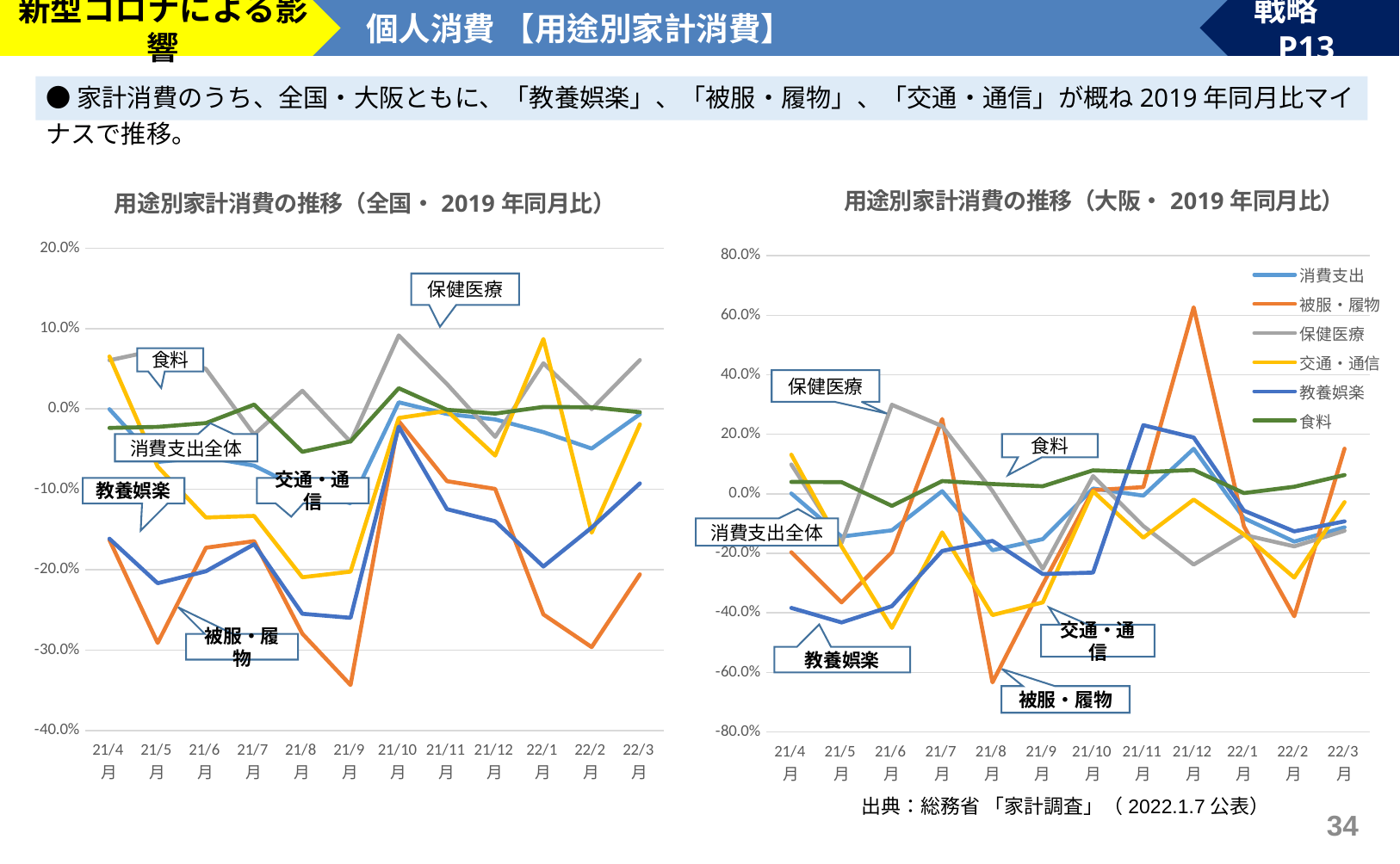
In the right chart (大阪), is the value for 被服・履物 at 21/12月 greater or less than 40.0%? greater In the right chart (大阪), does the 被服・履物 line rise or fall from 21/12月 to 22/2月? fall In the left chart (全国), is the value for 被服・履物 at 21/9月 greater or less than -30.0%? less In the left chart (全国), at 21/9月, which is larger: 保健医療 or 被服・履物? 保健医療 In the right chart (大阪), which series reaches the highest value on the chart? 被服・履物 In the left chart (全国), is the value for 保健医療 at 21/10月 greater or less than 0.0%? greater What kind of chart is the left chart titled 用途別家計消費の推移（全国・2019年同月比）? line chart In the left chart (全国), which series has the lowest value at 21/9月? 被服・履物 In the left chart (全国), how many months are shown along the x axis? 12 What is the title of the right chart? 用途別家計消費の推移（大阪・2019年同月比） In the right chart (大阪), how many series does the legend list? 6